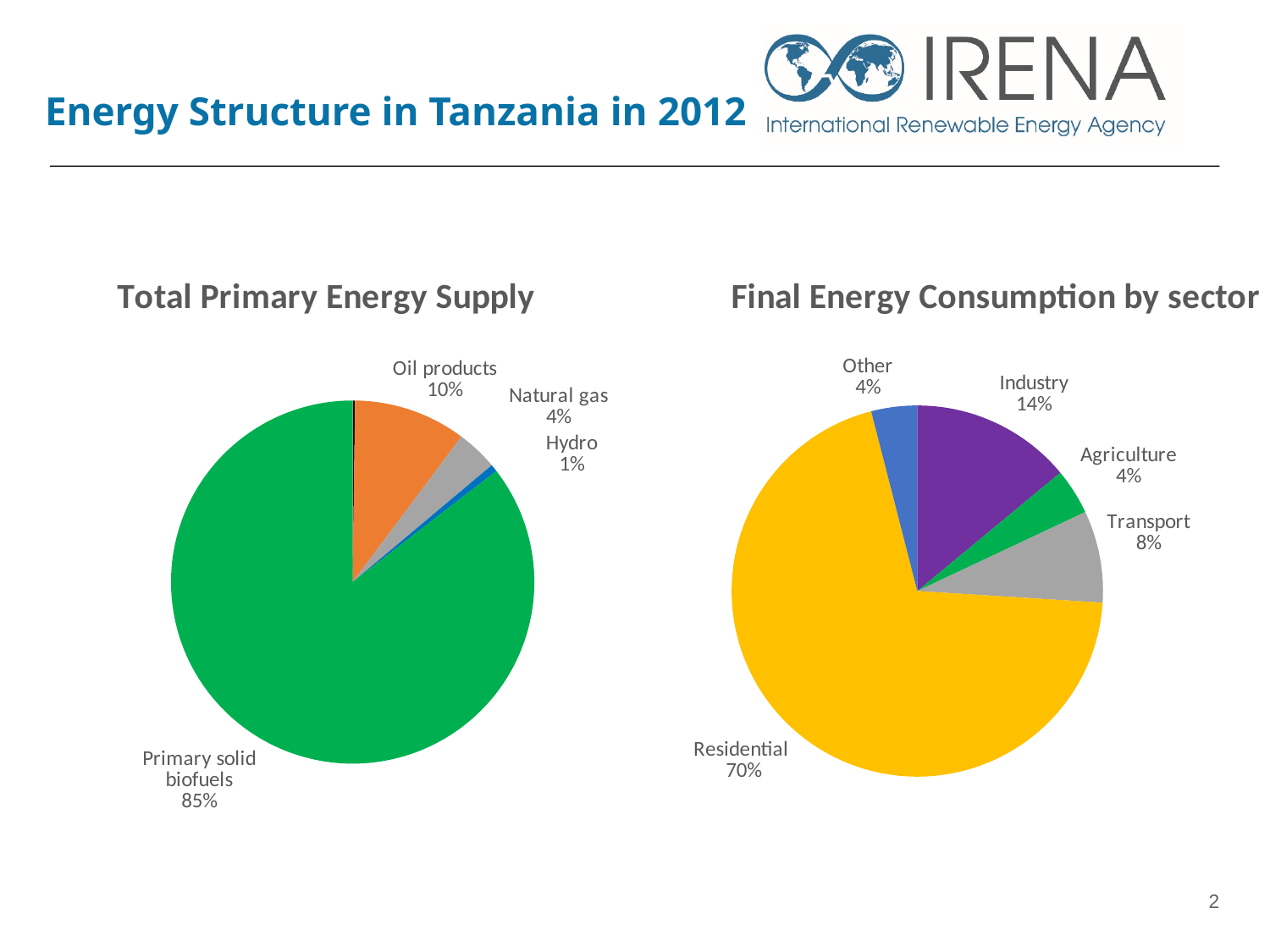
What kind of chart is the Total Primary Energy Supply chart? Pie chart In the Total Primary Energy Supply chart, what share does Primary solid biofuels have? 85% In the Final Energy Consumption by sector chart, what is the difference between the shares of Industry and Transport? 6% In the Final Energy Consumption by sector chart, what share does Industry have? 14% In the Total Primary Energy Supply chart, what is the difference between the shares of Oil products and Natural gas? 6% In the Final Energy Consumption by sector chart, which sector has the largest share? Residential In the Final Energy Consumption by sector chart, what share does Residential have? 70% In the Final Energy Consumption by sector chart, how many sectors are shown? 5 In the Total Primary Energy Supply chart, what share does Oil products have? 10% In the Final Energy Consumption by sector chart, which is larger, Transport or Agriculture? Transport